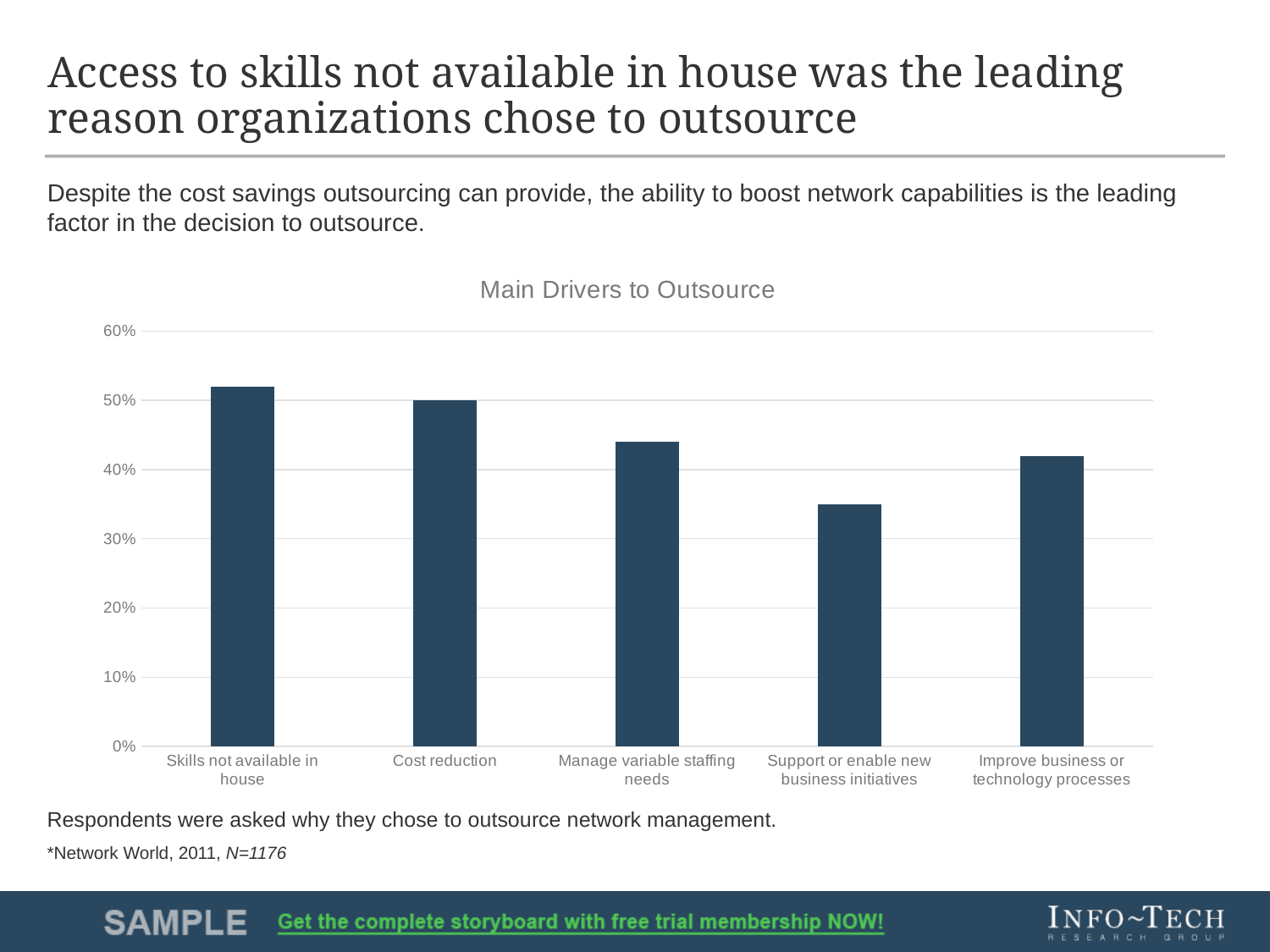
Is the value for Support or enable new business initiatives greater or less than 40%? less How many categories are shown in the chart? 5 Is the value for Improve business or technology processes greater or less than 40%? greater Which category has the lowest value? Support or enable new business initiatives Is the value for Manage variable staffing needs greater or less than 40%? greater Which category has the highest value? Skills not available in house What is the highest value shown on the vertical axis? 60% What is the title of the chart? Main Drivers to Outsource What kind of chart is shown on the slide? bar chart Which is larger, the value for Cost reduction or the value for Support or enable new business initiatives? Cost reduction What is the value for Cost reduction? 50%